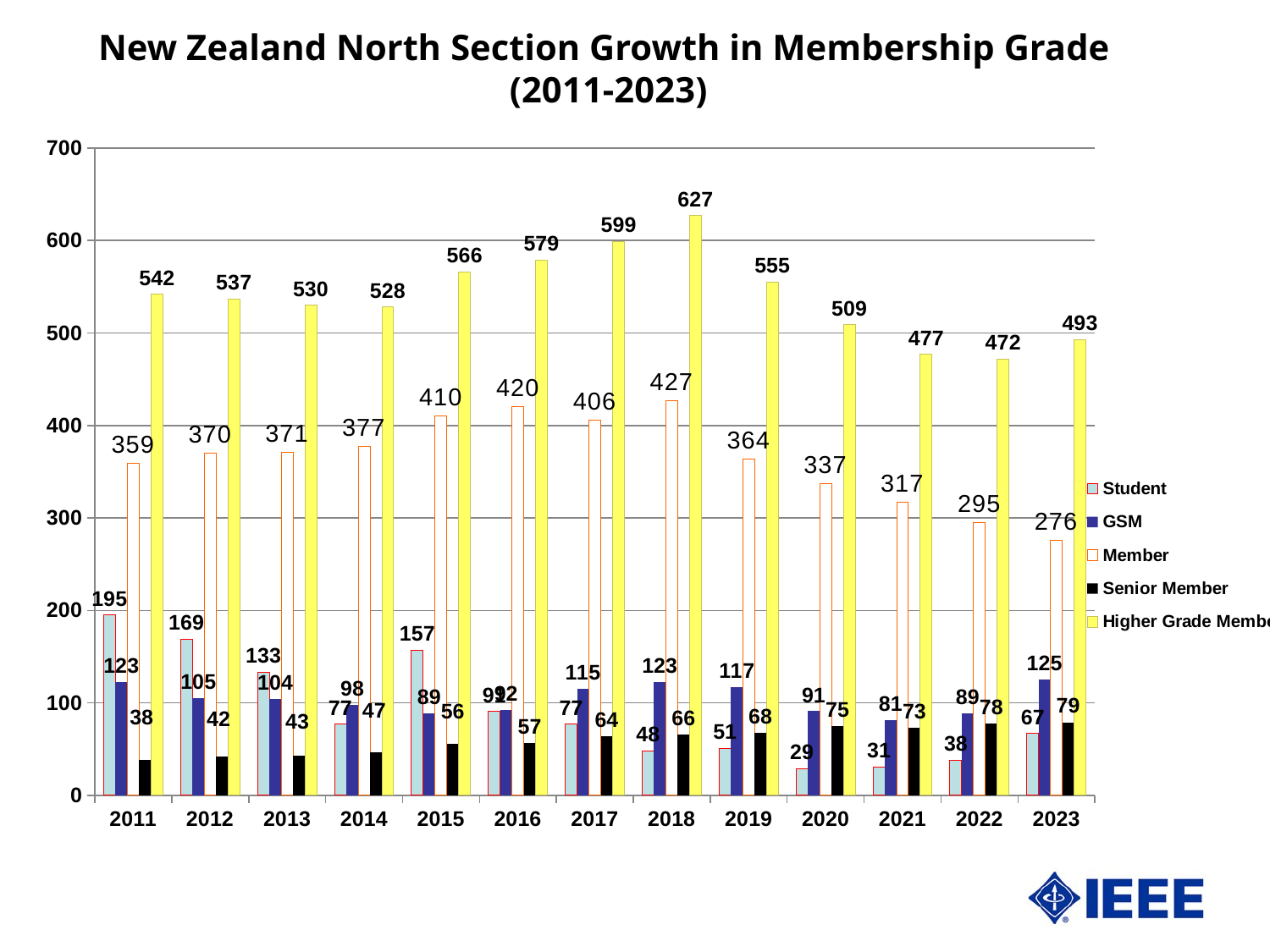
Is the Member value for 2023 greater or less than 300? less Do the Senior Member values generally rise or fall from 2011 to 2023? rise What is the difference between the Higher Grade Member values for 2018 and 2023? 134 How many series does the legend list? 5 What kind of chart is shown on the slide? bar chart In which year is the Higher Grade Member value highest? 2018 What is the Senior Member value for 2011? 38 Which year has the larger Student value, 2011 or 2012? 2011 What is the Higher Grade Member value for 2018? 627 How many years are shown on the x axis? 13 In which year is the Student value lowest? 2020 What is the Member value for 2015? 410